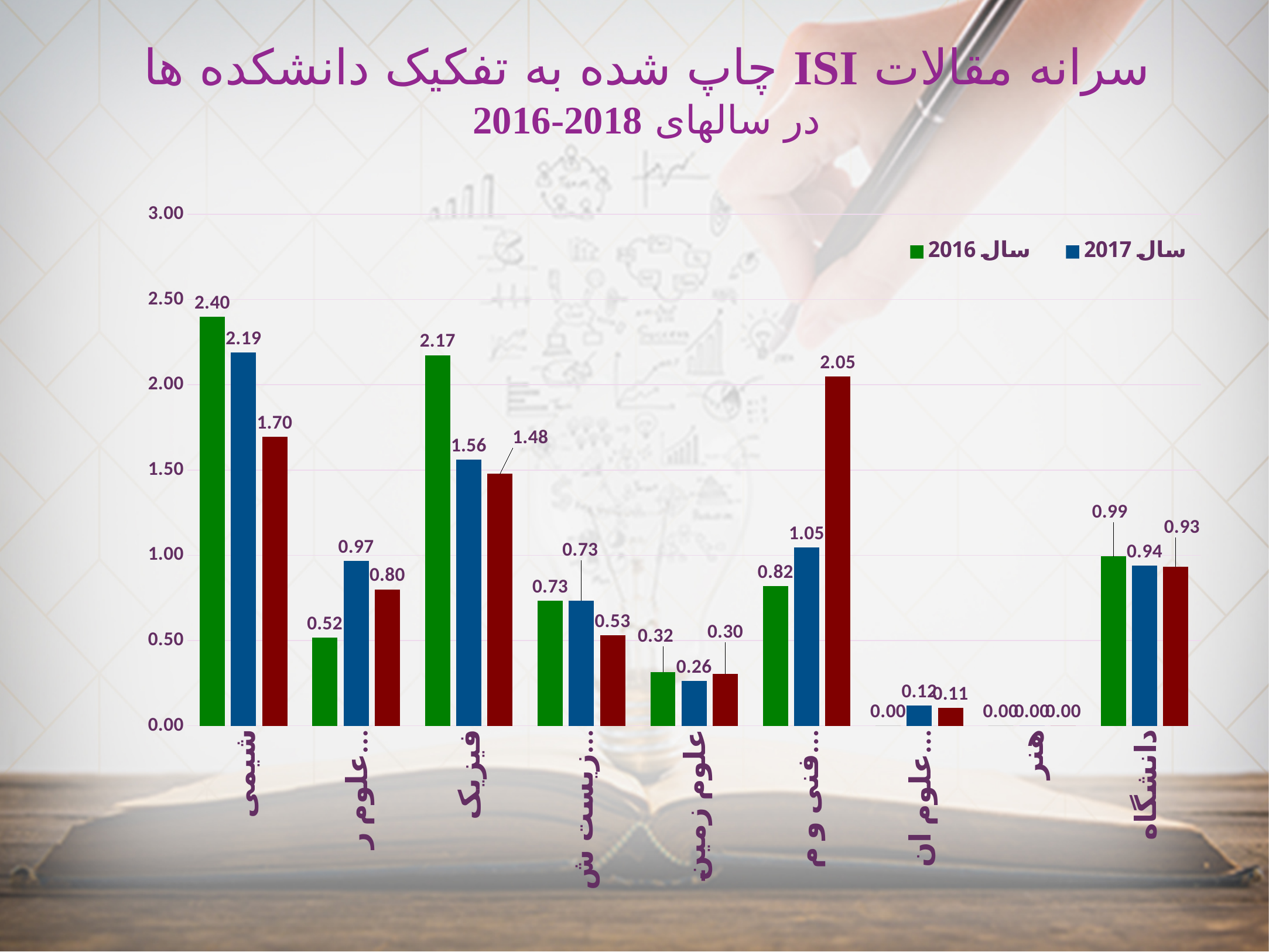
Which category has the lowest value in the سال 2017 series? هنر How many categories are shown on the x axis of the chart? 9 What is the difference between the سال 2016 and سال 2017 values for شیمی? 0.21 What is the value of the سال 2017 series for فیزیک? 1.56 Which category has the highest value in the سال 2016 series? شیمی What kind of chart is shown on the slide? bar chart What is the value of the dark red bar for علوم زمین? 0.30 Is the value of the dark red bar for شیمی greater or less than 1.50? greater How many series does the legend list? 2 Which has the larger سال 2016 value, فیزیک or دانشگاه? فیزیک What colour represents the سال 2016 series in the legend? green What is the value of the سال 2016 series for شیمی? 2.40